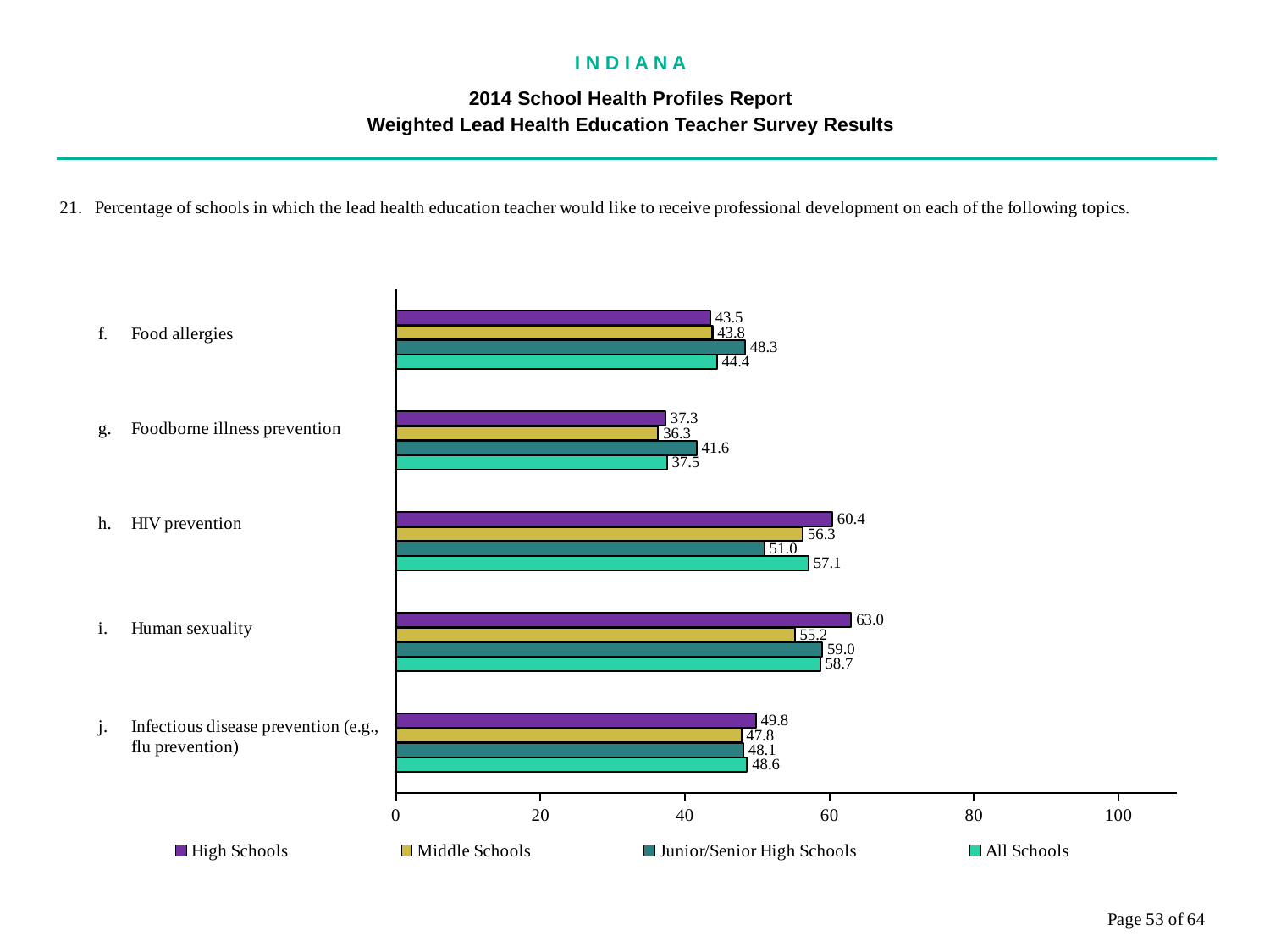
How many series does the legend list? 4 What is the difference between the High Schools and Middle Schools values for HIV prevention? 4.1 What is the value for Junior/Senior High Schools for Foodborne illness prevention? 41.6 How many topics are shown on the chart? 5 Which topic has the highest value for High Schools? Human sexuality What kind of chart is shown? Bar chart What is the value for All Schools for HIV prevention? 57.1 Which series is shown in purple in the legend? High Schools Which is larger for Food allergies: the Junior/Senior High Schools value or the High Schools value? Junior/Senior High Schools What is the value for Middle Schools for Infectious disease prevention (e.g., flu prevention)? 47.8 What is the value for High Schools for Human sexuality? 63.0 Which topic has the lowest value for All Schools? Foodborne illness prevention